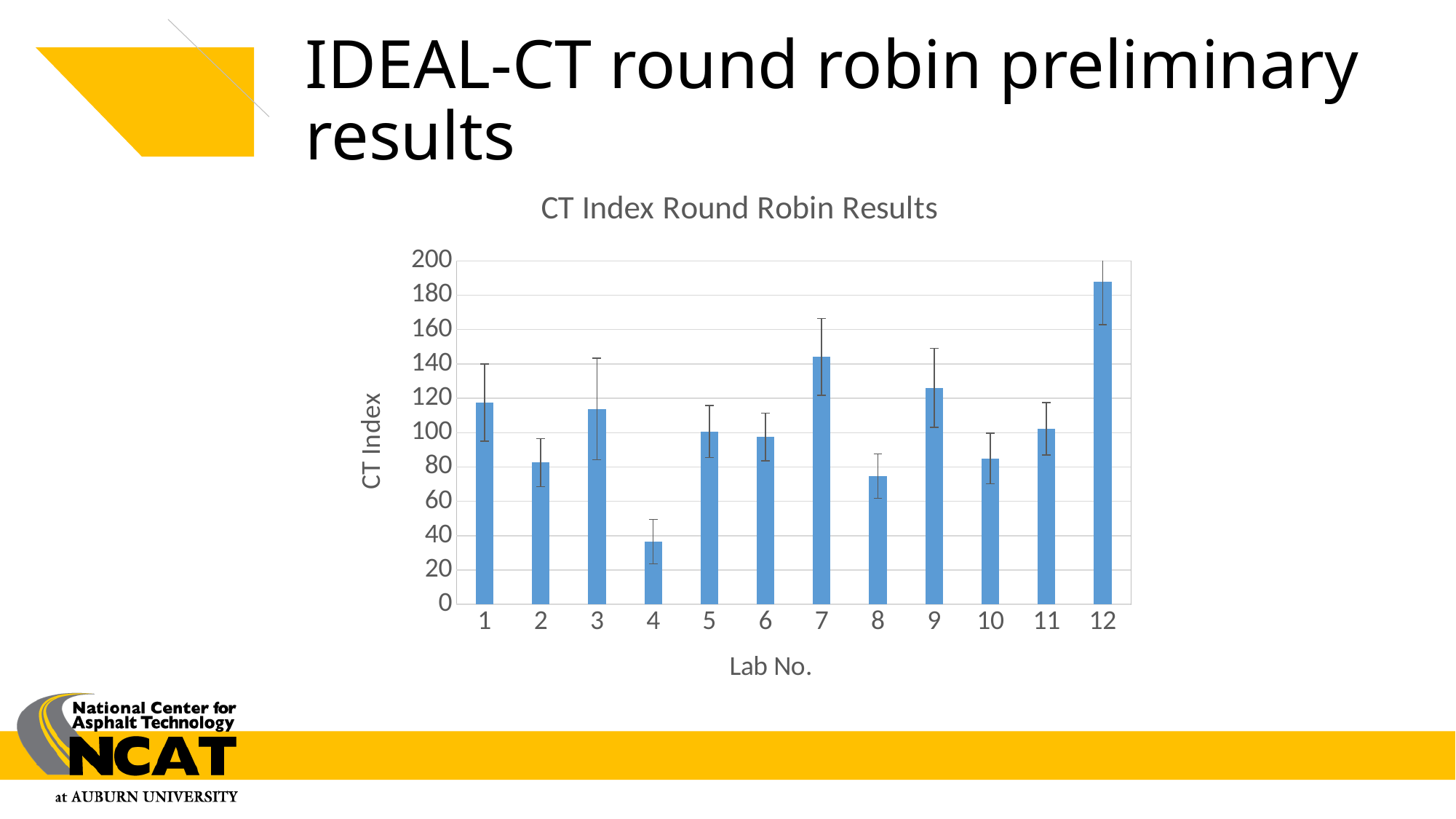
Is the CT Index for Lab 12 greater or less than 180? greater Is the CT Index for Lab 10 greater or less than 100? less Is the CT Index for Lab 8 greater or less than 80? less Which lab has a higher CT Index, Lab 7 or Lab 9? Lab 7 How many labs are plotted on the x axis of the chart? 12 Which lab has the lowest CT Index? Lab 4 What is the title of the chart? CT Index Round Robin Results What type of chart is shown on the slide? Bar chart Which lab has a higher CT Index, Lab 1 or Lab 2? Lab 1 Which lab has the highest CT Index? Lab 12